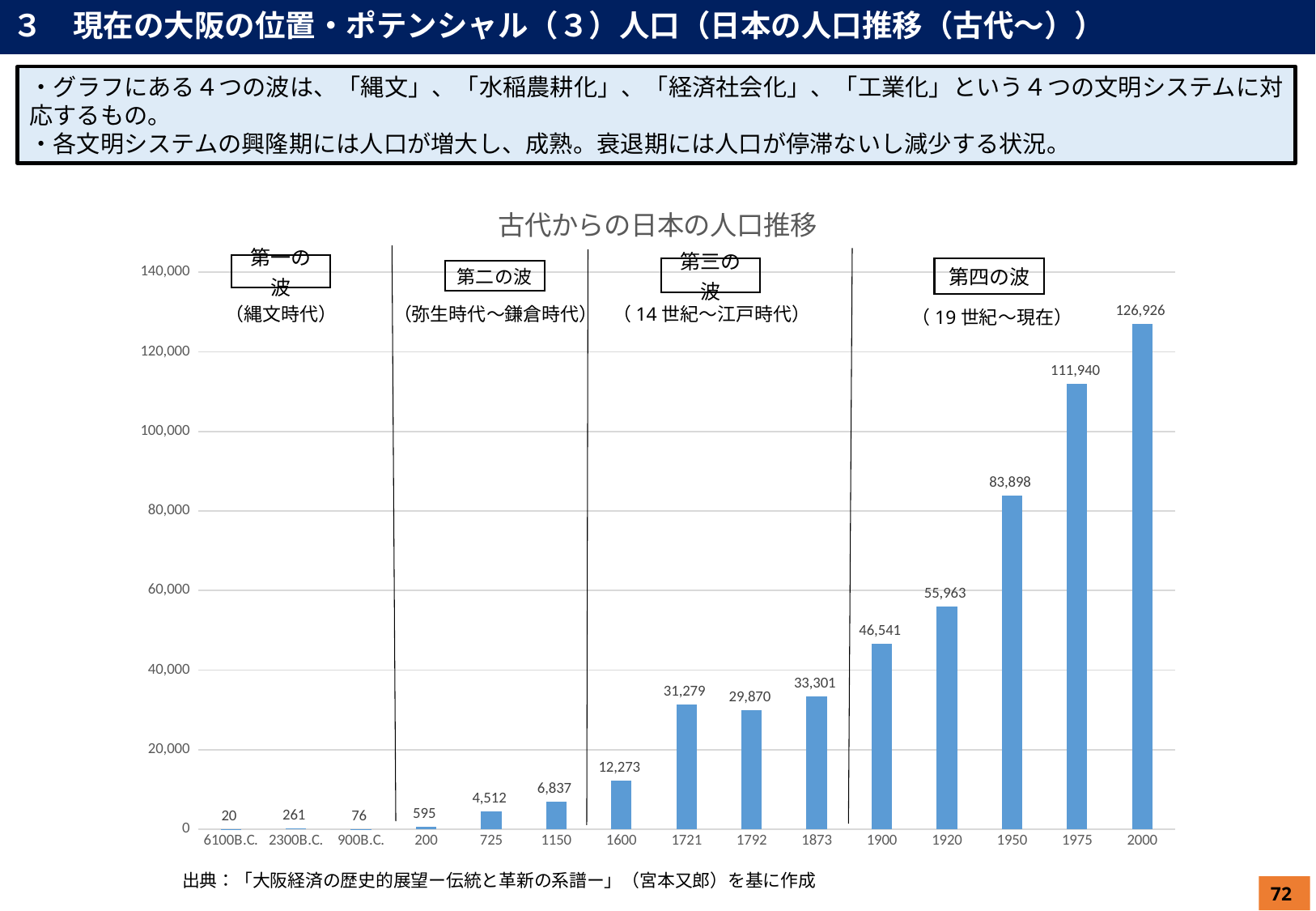
What is the difference between the values for 2000 and 1975? 14,986 What kind of chart is shown on the slide? bar chart Is the value for 1950 greater or less than 80,000? greater What is the value for 1721 in the chart? 31,279 Which category has the highest value in the chart? 2000 Which category has the lowest value in the chart? 6100B.C. What is the difference between the values for 1873 and 1792? 3,431 Which is larger, the value for 1721 or the value for 1792? 1721 How many categories are shown on the x axis of the chart? 15 What is the value for 2000 in the chart? 126,926 What is the value for 725 in the chart? 4,512 What is the title of the chart? 古代からの日本の人口推移